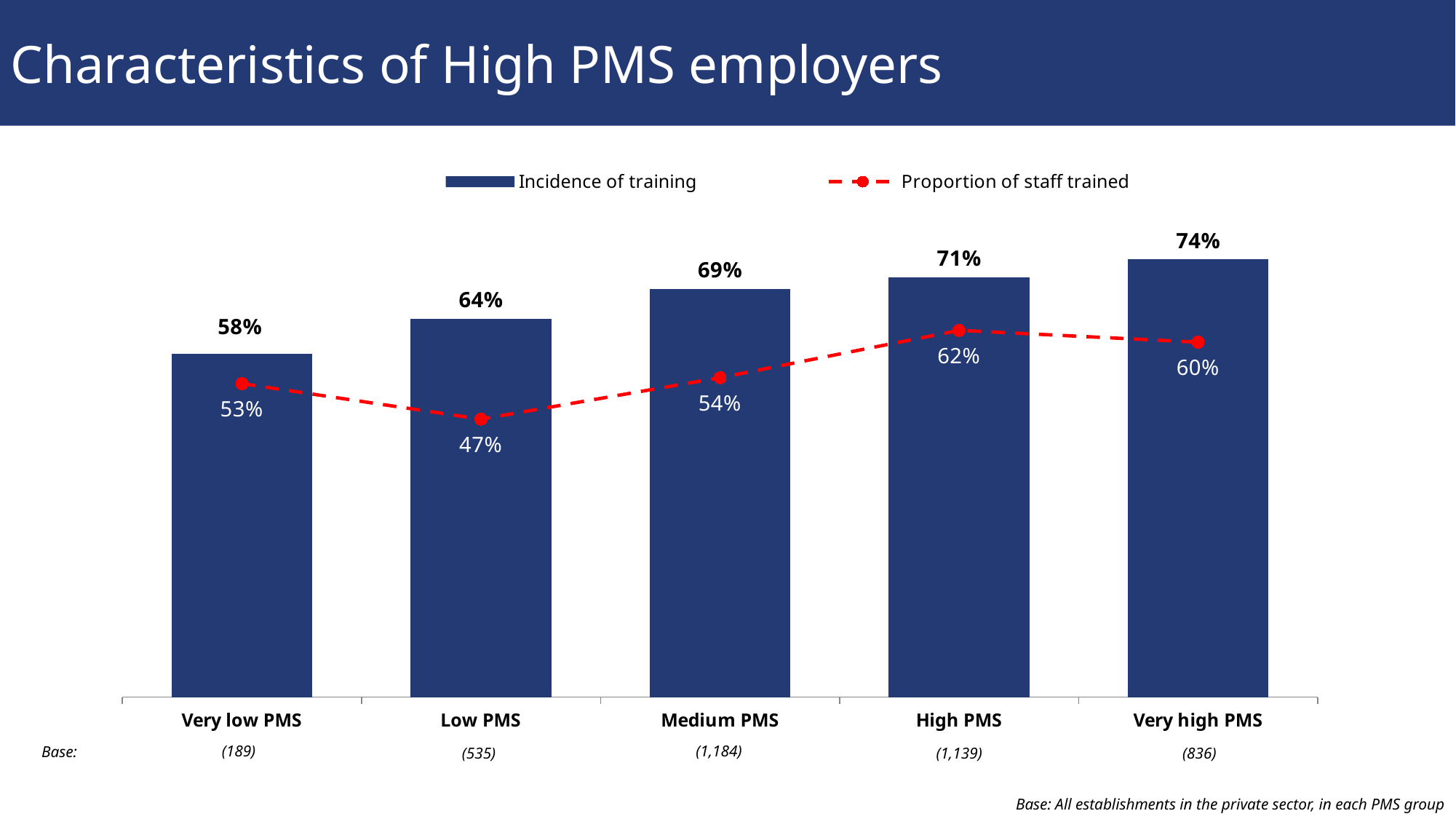
What is the incidence of training for Medium PMS employers? 69% Which PMS group has the highest incidence of training? Very high PMS Does the incidence of training rise or fall from Very low PMS to Very high PMS? Rises What is the base (number of establishments) for the Medium PMS group? 1,184 What is the difference in incidence of training between Very high PMS and Very low PMS employers? 16 percentage points What proportion of staff were trained among Low PMS employers? 47% Which is larger: the proportion of staff trained for High PMS or for Very high PMS? High PMS Which series is shown as a red dashed line? Proportion of staff trained How many PMS groups are shown on the x axis? 5 How many series does the legend list? 2 What kind of chart is used to show the incidence of training? Bar chart Which PMS group has the lowest proportion of staff trained? Low PMS